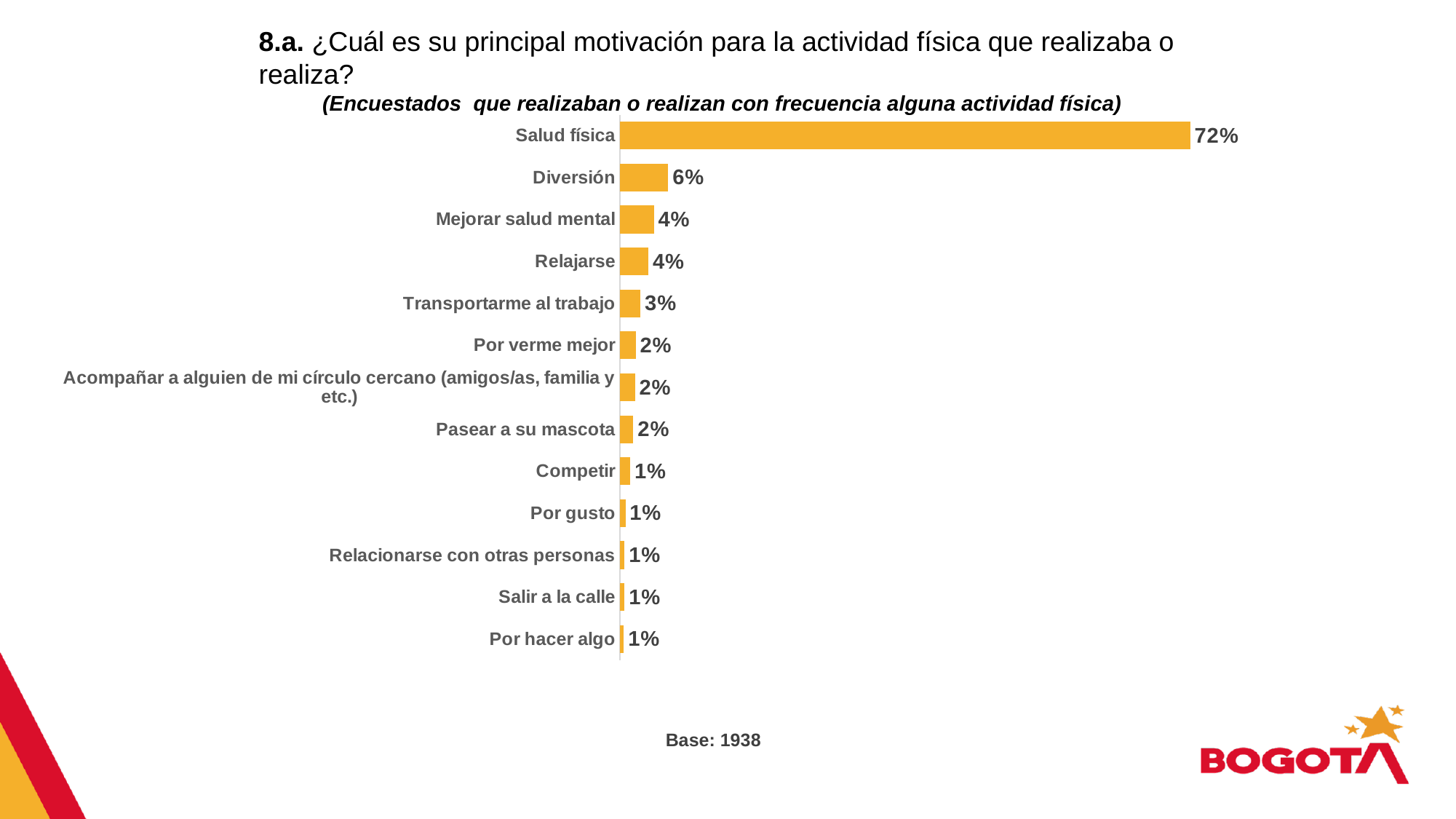
Which is larger, the value for Diversión or the value for Relajarse? Diversión What is the value for Salud física? 72% What is the value for Diversión? 6% How many categories are shown in the chart? 13 What is the difference between the values for Diversión and Mejorar salud mental? 2% Which category has the highest value? Salud física What kind of chart is shown on the slide? Bar chart What is the value for Transportarme al trabajo? 3% What is the difference between the values for Salud física and Diversión? 66% What is the base (number of respondents) shown below the chart? 1938 Which is larger, the value for Transportarme al trabajo or the value for Competir? Transportarme al trabajo What is the value for Pasear a su mascota? 2%